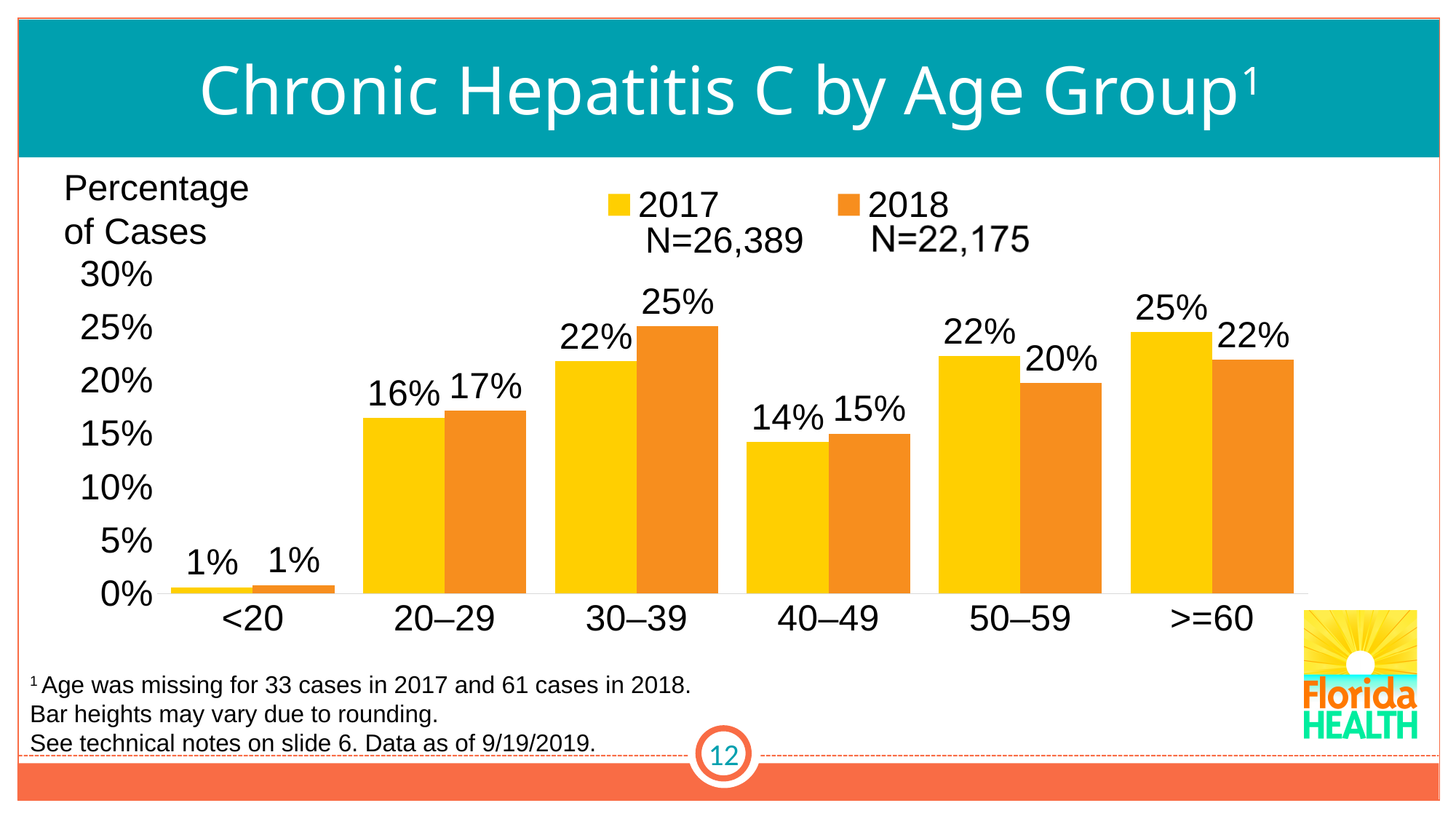
What percentage of cases were in the 50–59 age group in 2017? 22% What percentage of cases were in the 30–39 age group in 2018? 25% What is the N value shown for 2018 in the legend? N=22,175 Which age group had the highest percentage of cases in 2017? >=60 What is the difference between the 2017 and 2018 percentages for the 30–39 age group? 3% What kind of chart is shown on the slide? Bar chart How many age groups are shown on the x axis? 6 Which age group had the lowest percentage of cases in 2018? <20 What percentage of cases were in the 40–49 age group in 2017? 14% Which age group had the highest percentage of cases in 2018? 30–39 How many series does the legend list? 2 Which year had the larger percentage of cases in the 50–59 age group, 2017 or 2018? 2017